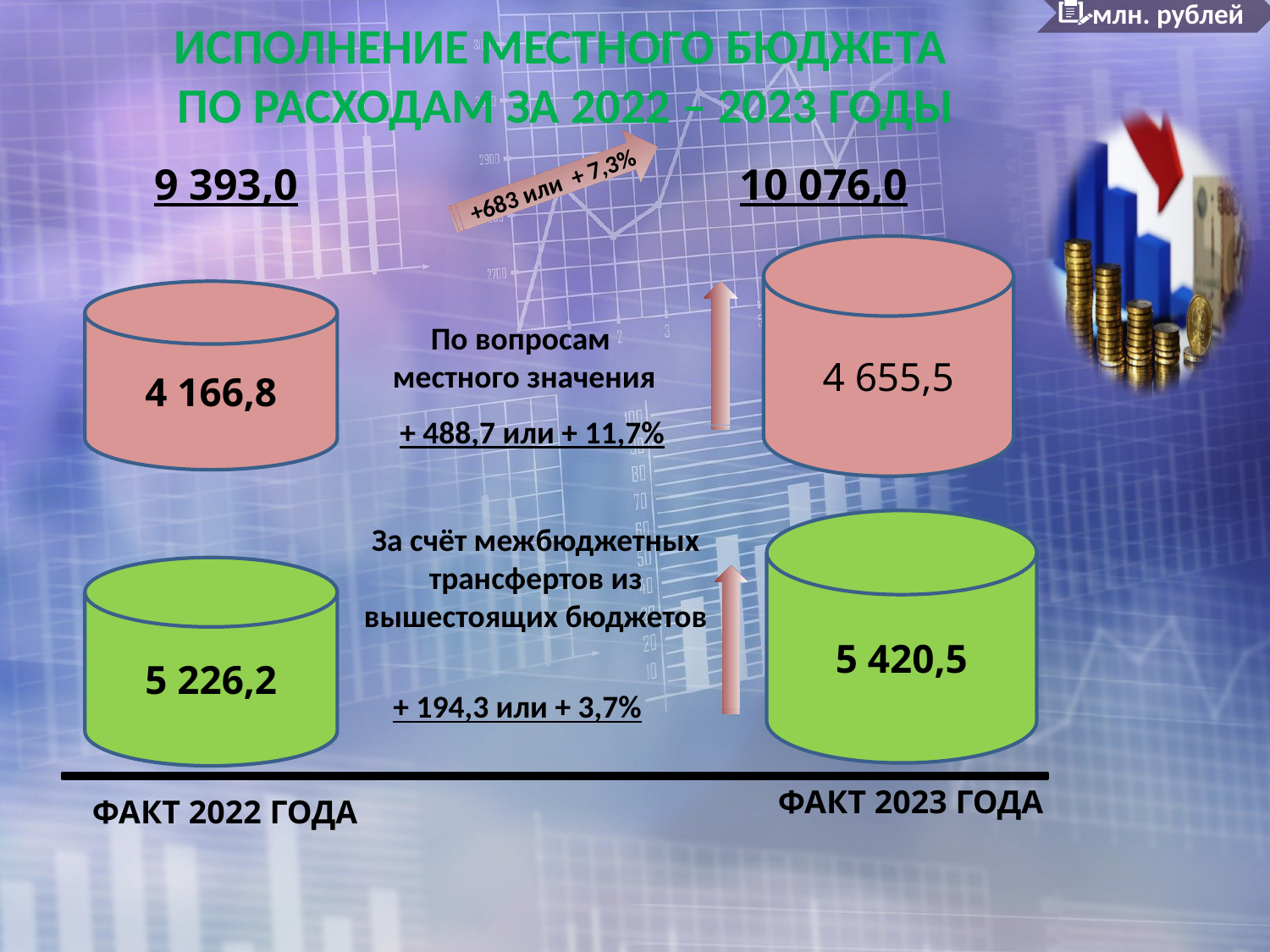
By how much did expenditure 'По вопросам местного значения' change from 2022 to 2023? + 488,7 или + 11,7% What is the value of expenditure 'За счёт межбюджетных трансфертов из вышестоящих бюджетов' in 2022? 5 226,2 In what units are the values on the slide expressed? млн. рублей By how much did total expenditure increase from 2022 to 2023, as printed on the arrow? +683 или + 7,3% What is the total local budget expenditure shown for ФАКТ 2022 ГОДА? 9 393,0 What is the value of expenditure 'По вопросам местного значения' in 2022? 4 166,8 By how much did expenditure from intergovernmental transfers change from 2022 to 2023? + 194,3 или + 3,7% In 2023, which is larger: expenditure 'По вопросам местного значения' or expenditure from intergovernmental transfers? За счёт межбюджетных трансфертов из вышестоящих бюджетов What is the value of expenditure 'По вопросам местного значения' in 2023? 4 655,5 What is the value of expenditure 'За счёт межбюджетных трансфертов из вышестоящих бюджетов' in 2023? 5 420,5 What is the total local budget expenditure shown for ФАКТ 2023 ГОДА? 10 076,0 Did total expenditure rise or fall from 2022 to 2023? rise